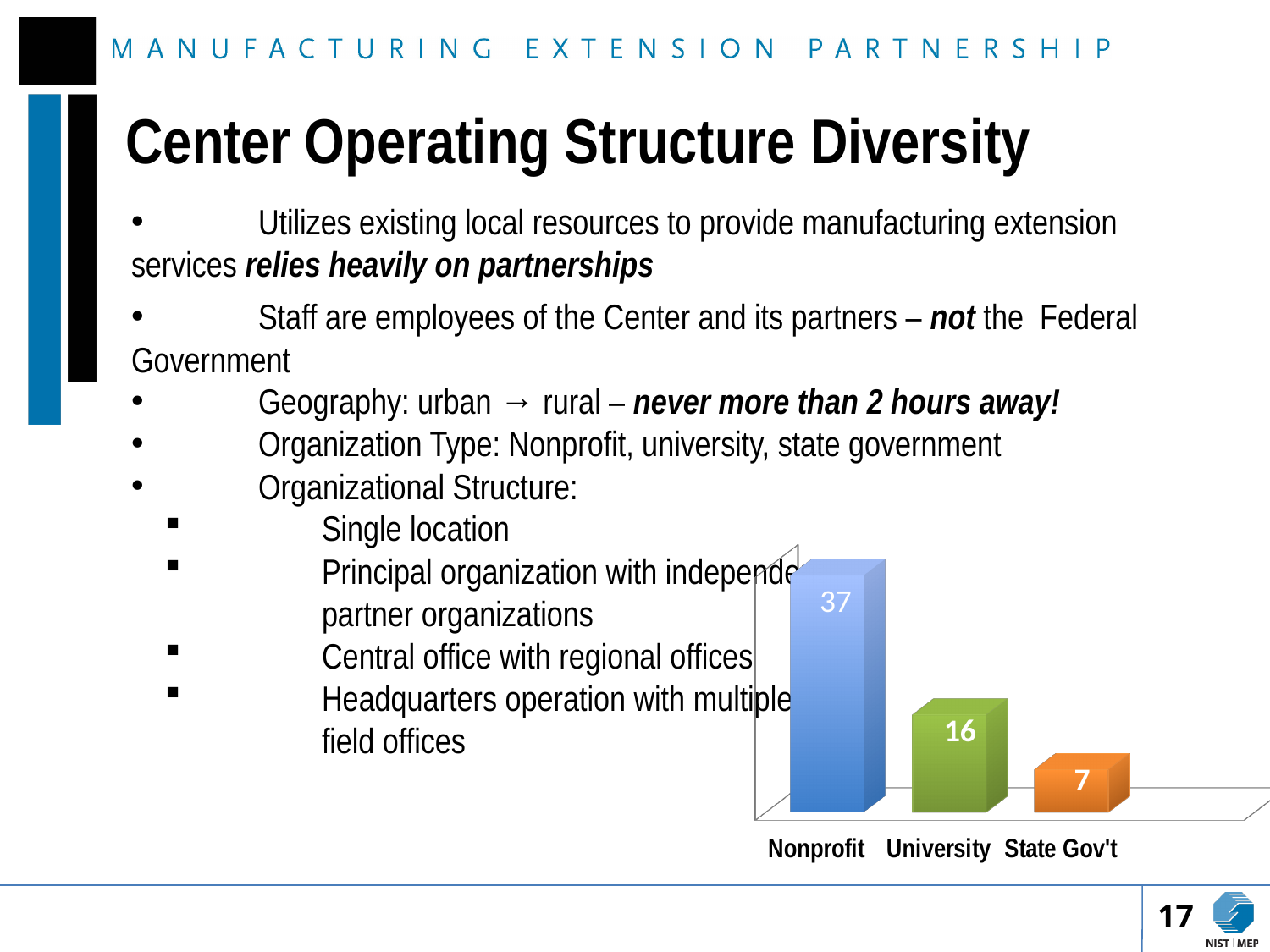
What kind of chart is shown on the slide? Bar chart Which category has the highest value? Nonprofit What is the difference between the Nonprofit and University values? 21 Which category has the lowest value? State Gov't What is the value for Nonprofit? 37 Do the values rise or fall from left to right across the categories? Fall What is the value for University? 16 What is the difference between the University and State Gov't values? 9 How many categories are shown in the chart? 3 Which is larger, the value for University or the value for State Gov't? University What colour is the Nonprofit bar? Blue What is the value for State Gov't? 7